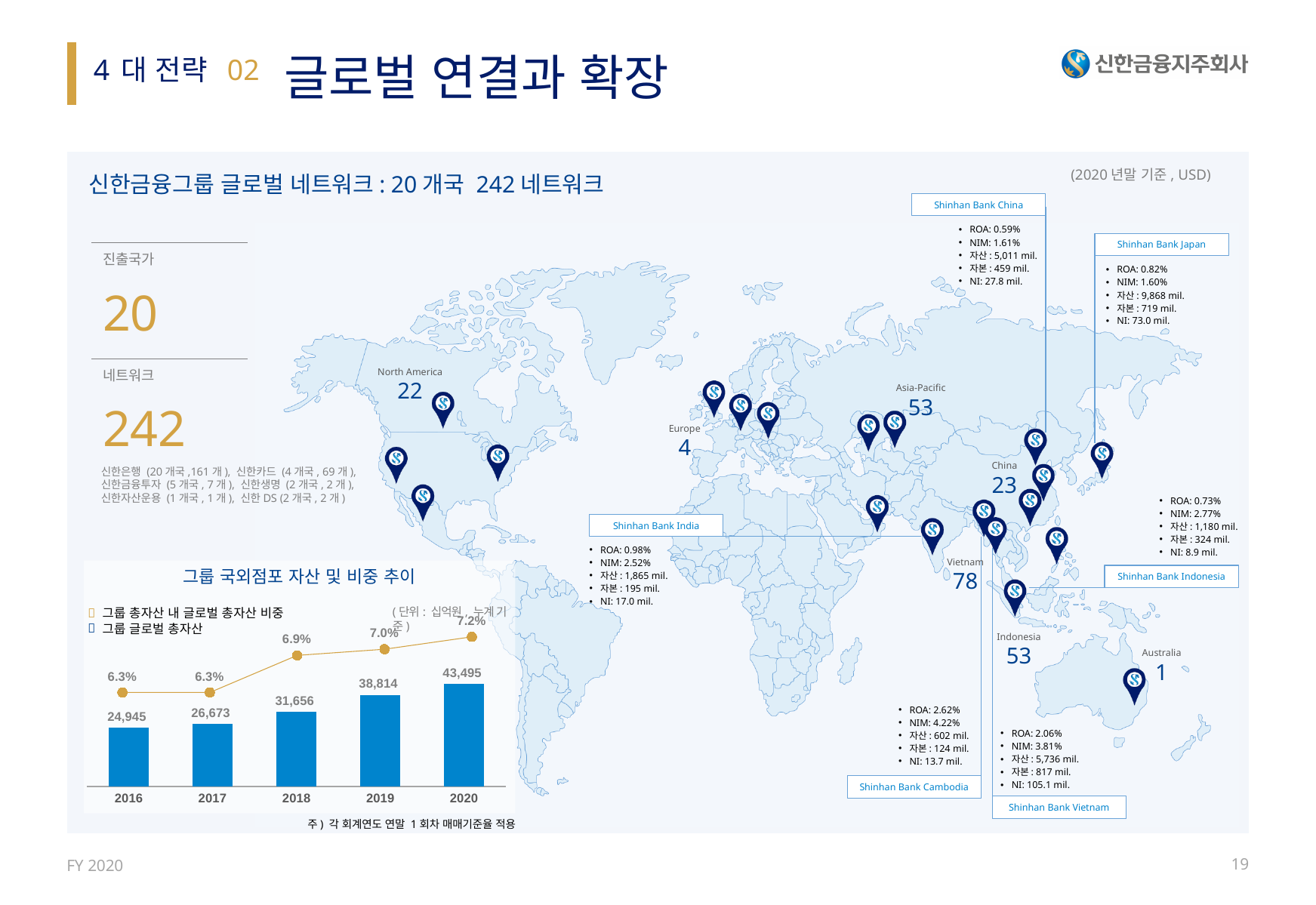
How many years are shown on the x axis of the chart '그룹 국외점포 자산 및 비중 추이'? 5 In the chart '그룹 국외점포 자산 및 비중 추이', which year has the highest 그룹 글로벌 총자산? 2020 In the chart '그룹 국외점포 자산 및 비중 추이', what is the 그룹 총자산 내 글로벌 총자산 비중 for 2018? 6.9% In the chart '그룹 국외점포 자산 및 비중 추이', what is the 그룹 총자산 내 글로벌 총자산 비중 for 2020? 7.2% How many series does the legend of the chart '그룹 국외점포 자산 및 비중 추이' list? 2 In the chart '그룹 국외점포 자산 및 비중 추이', what is the value of 그룹 글로벌 총자산 for 2016? 24,945 In the chart '그룹 국외점포 자산 및 비중 추이', does the 그룹 글로벌 총자산 rise or fall from 2016 to 2020? rise In the chart '그룹 국외점포 자산 및 비중 추이', which year has the lowest 그룹 글로벌 총자산? 2016 In the chart '그룹 국외점포 자산 및 비중 추이', is the 그룹 글로벌 총자산 larger in 2018 or in 2019? 2019 In the chart '그룹 국외점포 자산 및 비중 추이', what is the difference in 그룹 글로벌 총자산 between 2017 and 2016? 1,728 In the chart '그룹 국외점포 자산 및 비중 추이', what is the value of 그룹 글로벌 총자산 for 2020? 43,495 In the chart '그룹 국외점포 자산 및 비중 추이', what is the difference in 그룹 글로벌 총자산 between 2020 and 2019? 4,681